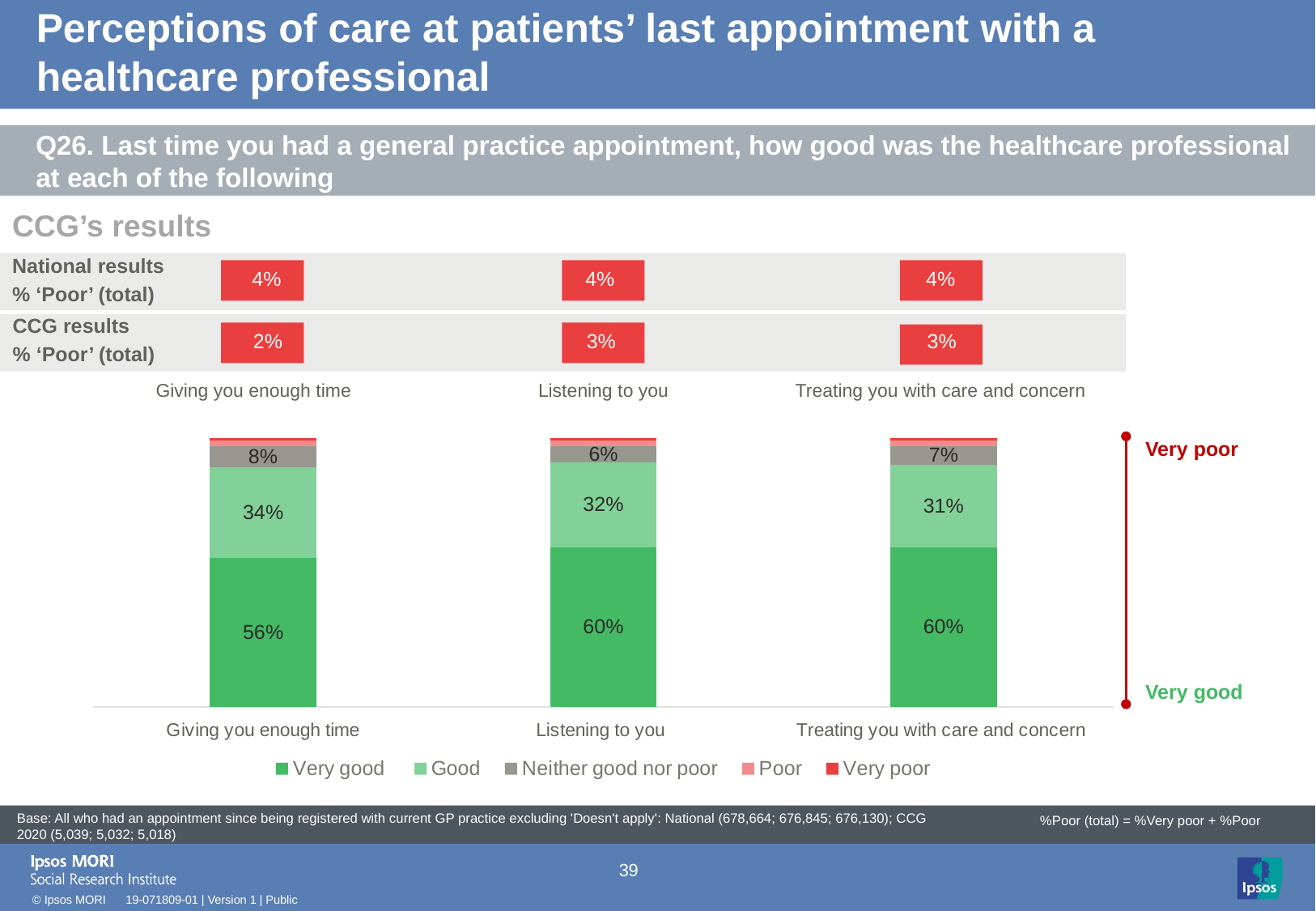
What percentage rated the healthcare professional 'Good' at listening to you? 32% Which category has the highest 'Neither good nor poor' percentage? Giving you enough time How many series does the legend of the stacked bar chart list? 5 What percentage of patients rated the healthcare professional 'Very good' at giving you enough time? 56% What is the difference between the 'Very good' percentage for listening to you and for giving you enough time? 4% What percentage rated the healthcare professional 'Neither good nor poor' at treating you with care and concern? 7% Which category has the lowest 'Very good' percentage? Giving you enough time What is the CCG '% Poor (total)' result for giving you enough time? 2% What is the national '% Poor (total)' result for listening to you? 4% How many categories are shown on the x axis of the stacked bar chart? 3 Is the 'Good' percentage larger for giving you enough time or for treating you with care and concern? Giving you enough time What kind of chart is used to show the ratings? Stacked bar chart